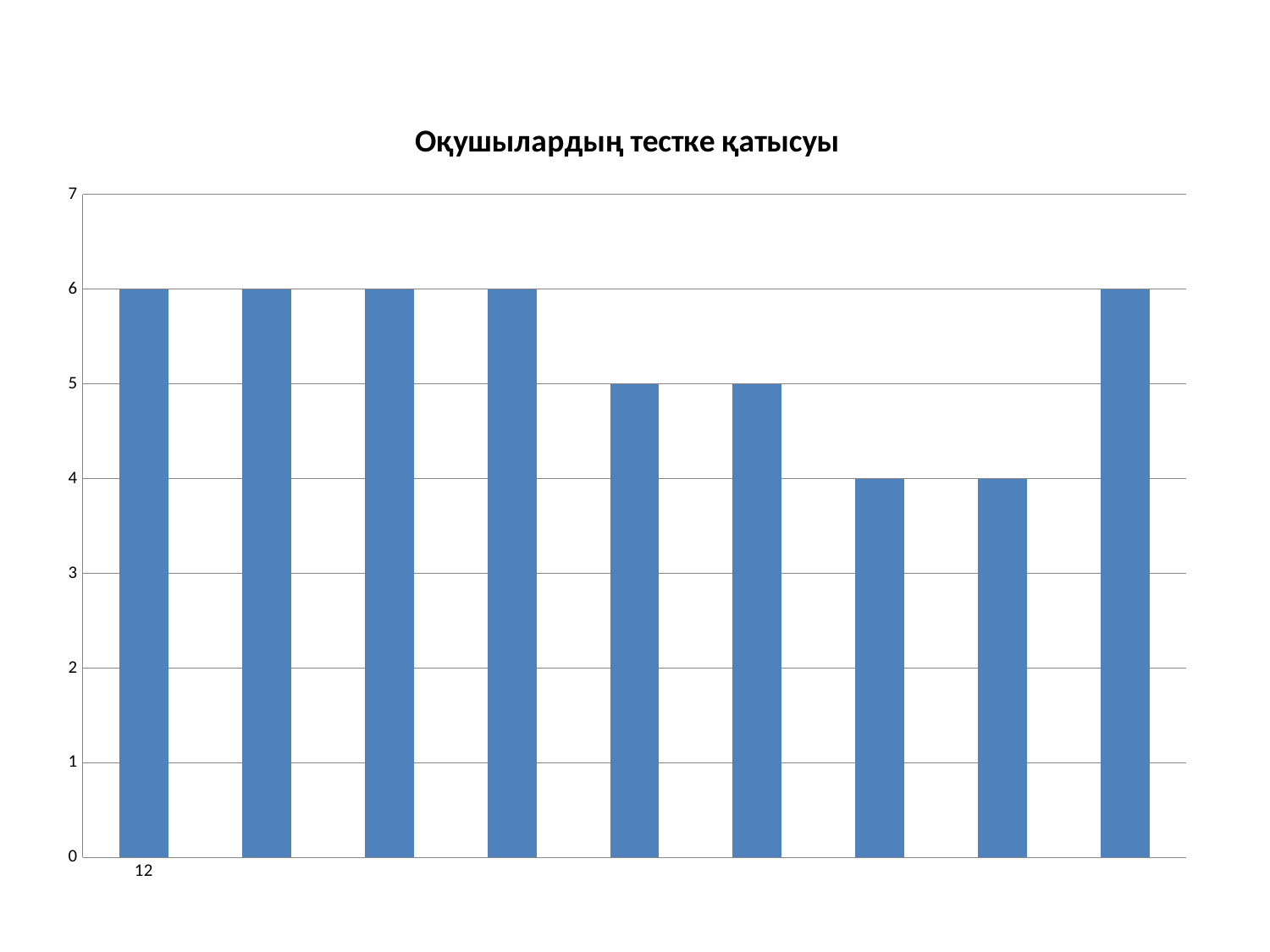
What is the lowest value reached by any bar in the chart? 4 What is the title of the chart? Оқушылардың тестке қатысуы What is the maximum value shown on the vertical axis? 7 How many bars are plotted in the chart? 9 How many bars have the value 4? 2 What kind of chart is shown on the slide? bar chart Is the first bar from the left larger or smaller than the seventh bar from the left? larger What is the value of the bar for category 12? 6 What is the difference between the tallest bar and the shortest bar? 2 Is the value for category 12 greater or less than 5? greater How many bars reach the value 6? 5 What is the highest value reached by any bar in the chart? 6